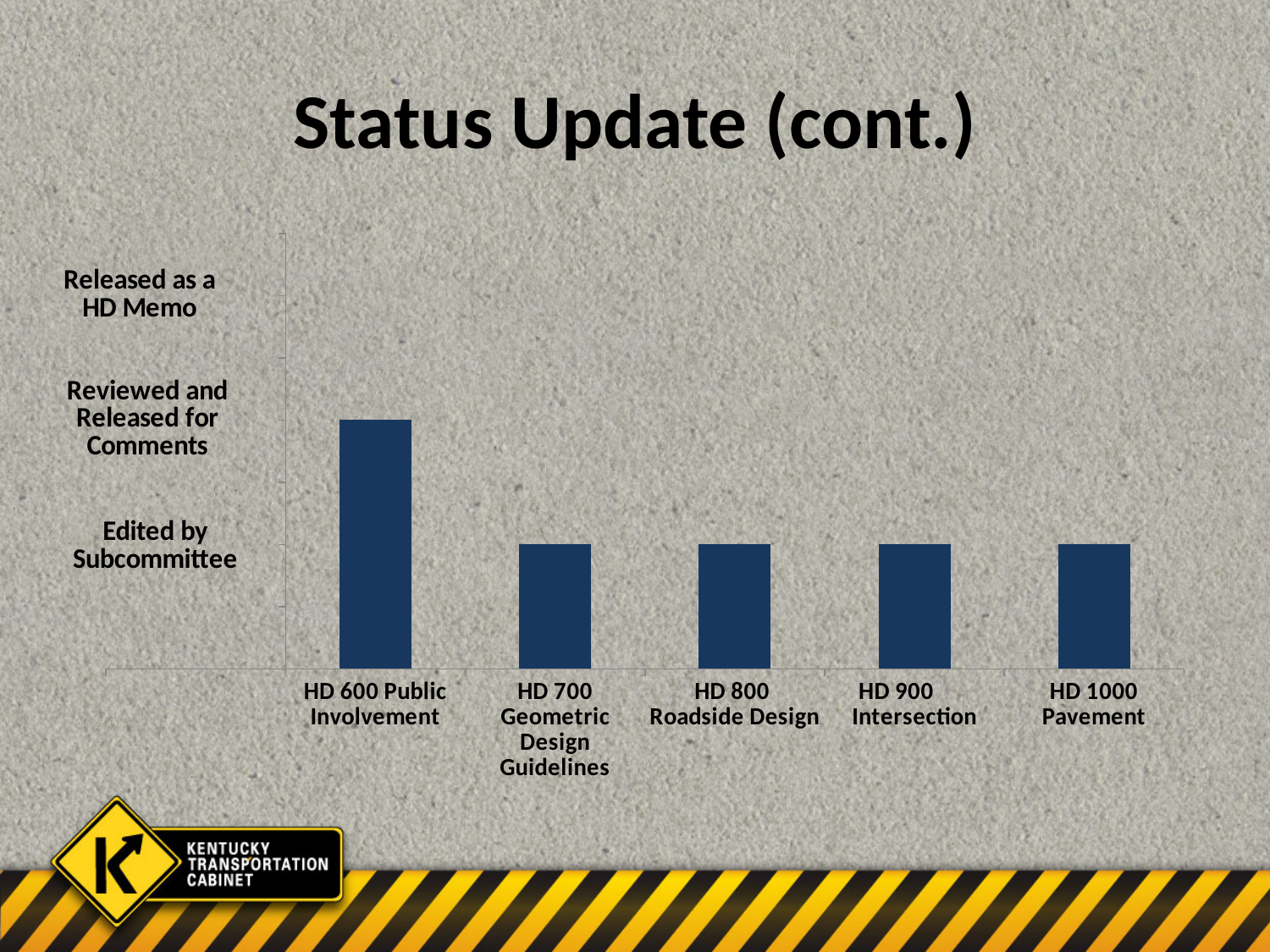
What is the highest status level labelled on the y axis of the chart? Released as a HD Memo Have any of the categories in the chart reached the 'Released as a HD Memo' level? No What status level does the bar for HD 600 Public Involvement reach? Reviewed and Released for Comments How many categories are plotted on the x axis of the chart? 5 What is the title of the slide containing the chart? Status Update (cont.) What status level does the bar for HD 700 Geometric Design Guidelines reach? Edited by Subcommittee Which category has the highest bar in the chart? HD 600 Public Involvement What kind of chart is shown on the slide? bar chart What status level does the bar for HD 1000 Pavement reach? Edited by Subcommittee What status level does the bar for HD 900 Intersection reach? Edited by Subcommittee Which bar is taller, HD 600 Public Involvement or HD 900 Intersection? HD 600 Public Involvement What status level does the bar for HD 800 Roadside Design reach? Edited by Subcommittee